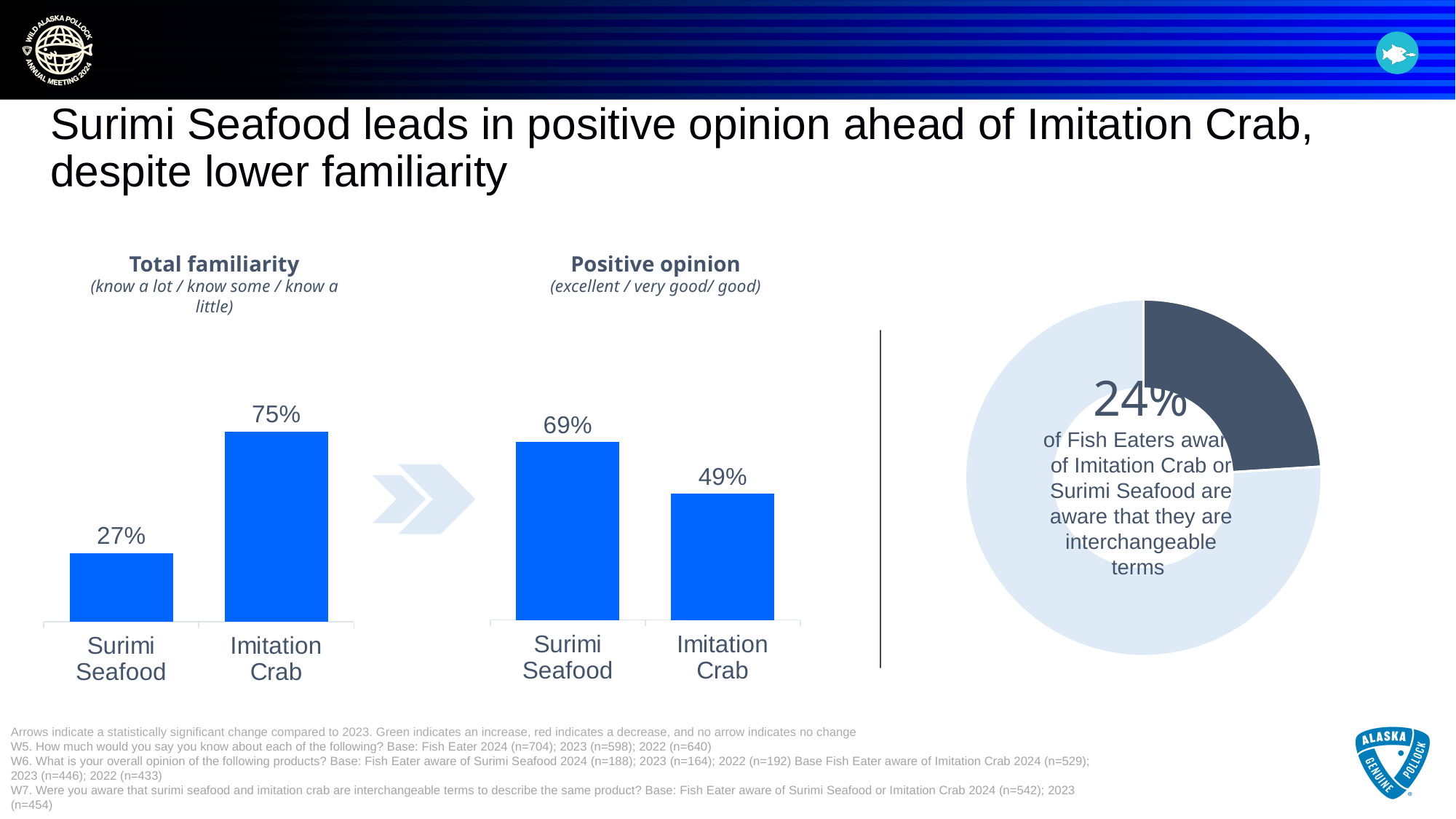
What kind of chart is the Total familiarity chart? Bar chart In the Positive opinion chart, what is the value for Imitation Crab? 49% In the Positive opinion chart, which category has the lowest value? Imitation Crab In the donut chart on the right, what share of Fish Eaters are aware that Imitation Crab and Surimi Seafood are interchangeable terms? 24% In the Total familiarity chart, what is the value for Surimi Seafood? 27% In the Positive opinion chart, what is the value for Surimi Seafood? 69% In the Total familiarity chart, what is the difference between Imitation Crab and Surimi Seafood? 48% In the Total familiarity chart, which category has the highest value? Imitation Crab In the Positive opinion chart, what is the difference between Surimi Seafood and Imitation Crab? 20% In the Total familiarity chart, what is the value for Imitation Crab? 75% In the Positive opinion chart, which is larger: Surimi Seafood or Imitation Crab? Surimi Seafood How many categories are shown in the Total familiarity chart? 2